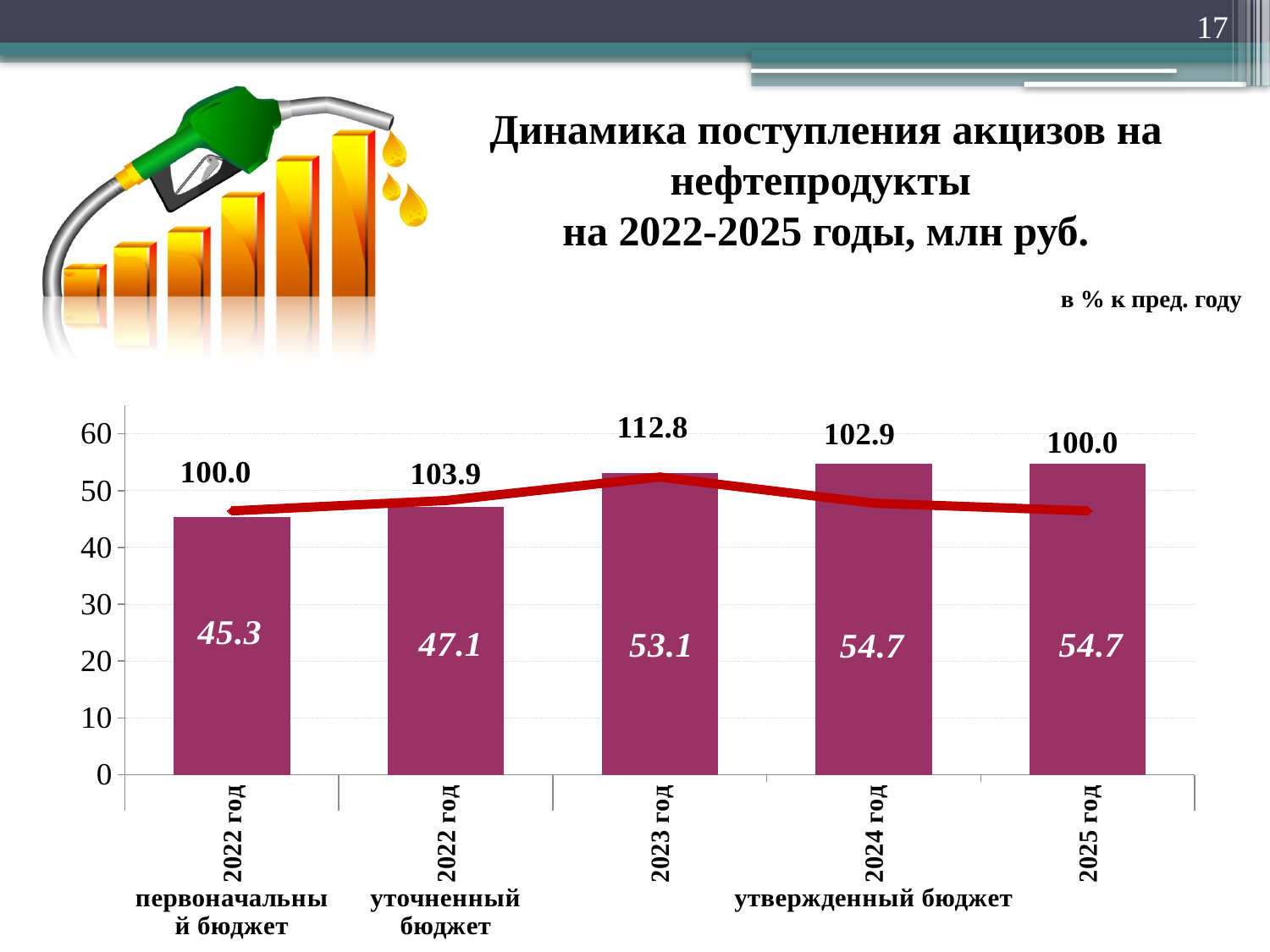
How many bars are plotted in the chart? 5 What is the title of the chart on the slide? Динамика поступления акцизов на нефтепродукты на 2022-2025 годы, млн руб. Which category has the lowest bar value? 2022 год (первоначальный бюджет) What is the bar value for 2022 год (первоначальный бюджет)? 45.3 What is the percentage to the previous year (в % к пред. году) shown for 2023 год? 112.8 What is the bar value for 2022 год (уточненный бюджет)? 47.1 Which is larger, the bar value for 2024 год or for 2023 год? 2024 год What is the percentage to the previous year shown for 2024 год? 102.9 Which year has the highest percentage to the previous year? 2023 год What is the difference between the bar values for 2023 год and 2022 год (уточненный бюджет)? 6.0 What type of chart is shown on the slide? Bar chart with a line overlay What is the bar value for 2023 год? 53.1